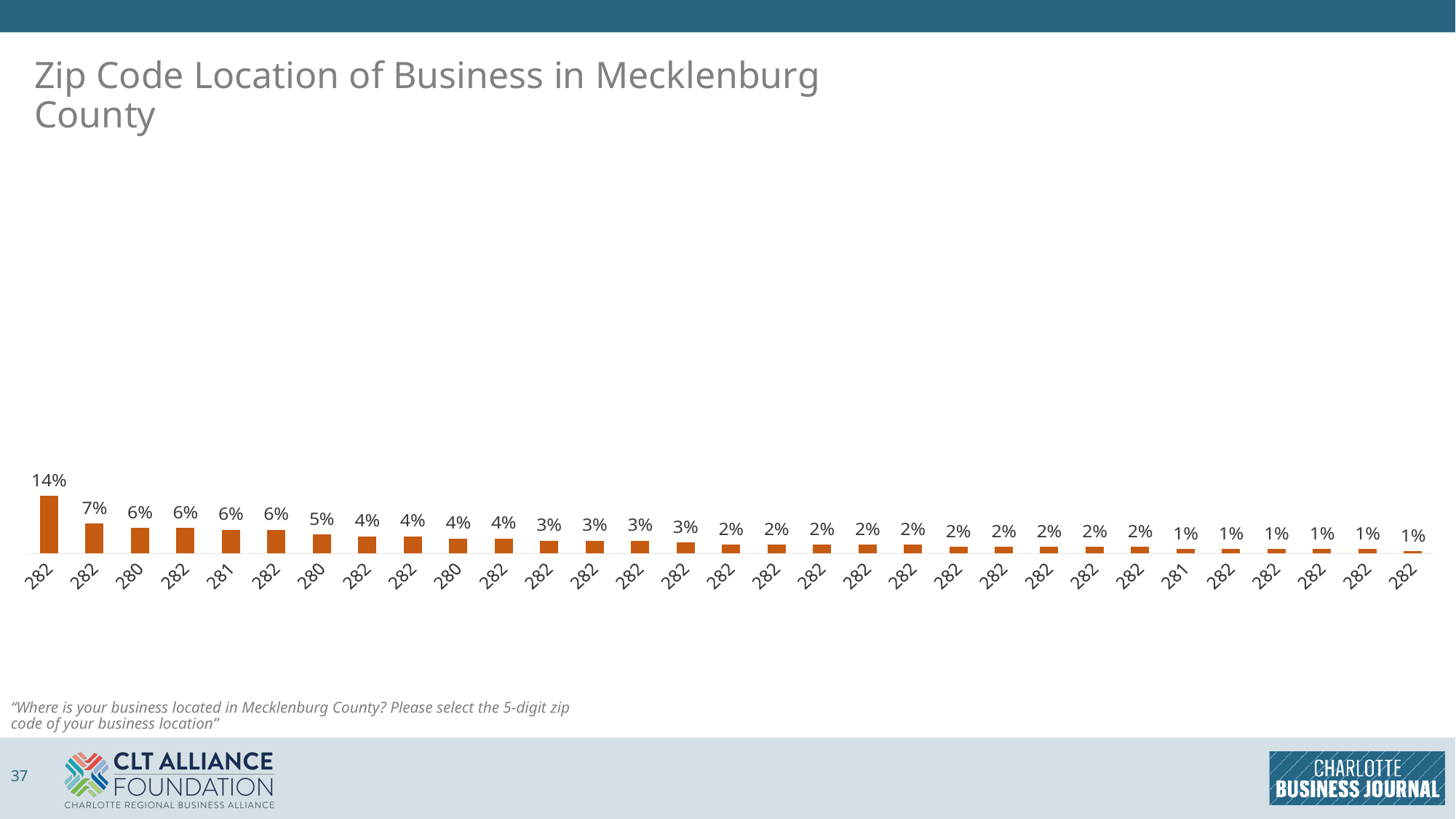
Which is larger, the first bar from the left or the second bar from the left? the first bar What is the difference in percentage points between the first bar (14%) and the second bar (7%)? 7 percentage points What is the title of the slide containing the chart? Zip Code Location of Business in Mecklenburg County What is the value of the seventh bar from the left? 5% Do the bar values rise or fall moving from left to right along the x axis? fall How many bars in the chart are labelled 1%? 6 What is the value of the tallest bar in the chart? 14% What kind of chart is shown on the slide? bar chart What is the value of the second bar from the left? 7% How many bars are plotted in the chart? 31 What is the value of the smallest bars in the chart? 1% How many bars in the chart are labelled 2%? 10